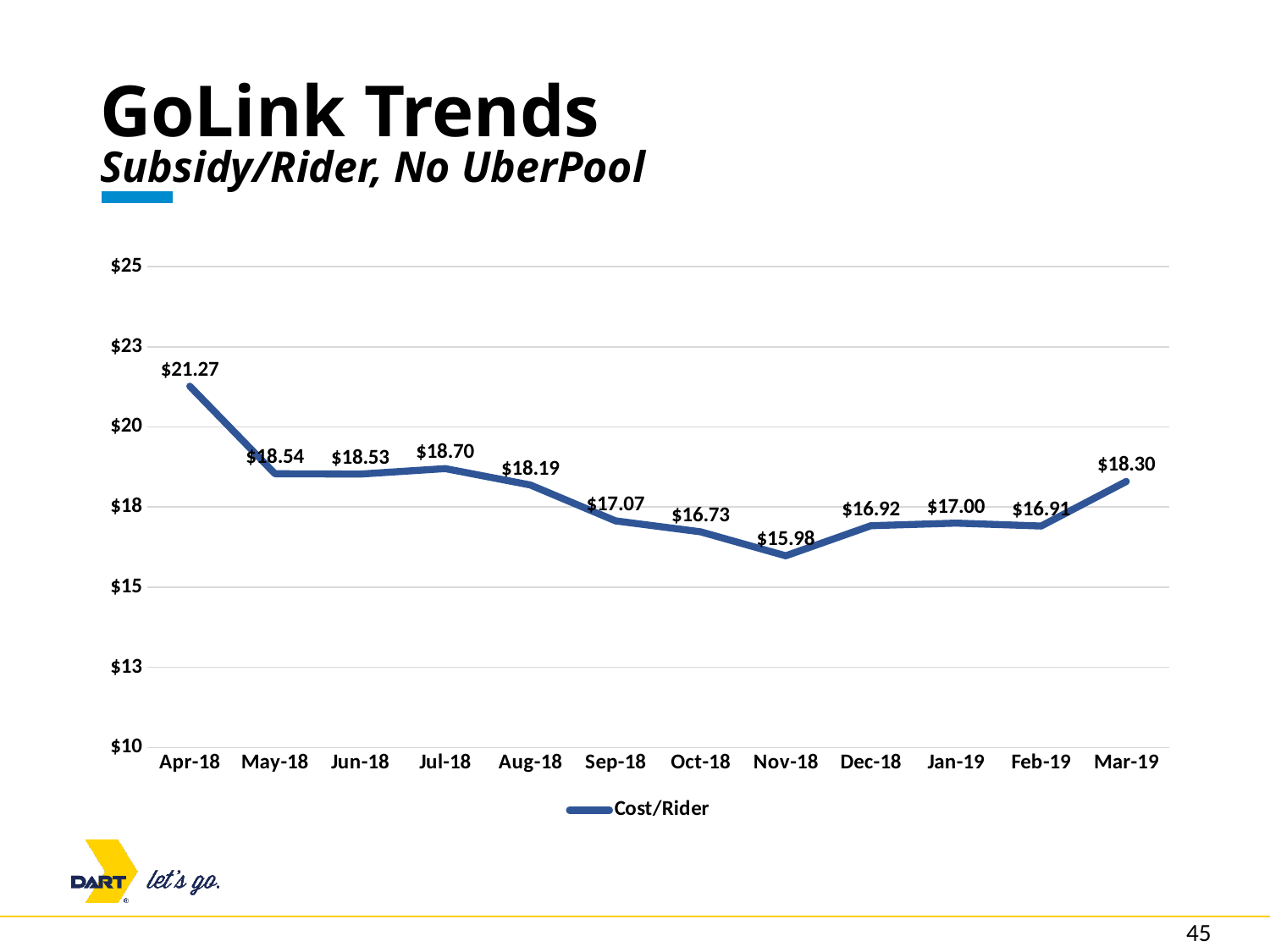
What is the Cost/Rider value for Nov-18? $15.98 What is the name of the series shown in the legend? Cost/Rider What kind of chart is shown on the slide? line chart Which has a higher Cost/Rider, Jul-18 or Sep-18? Jul-18 How many months are plotted on the chart? 12 What is the Cost/Rider value for Mar-19? $18.30 Which month has the highest Cost/Rider? Apr-18 Which month has the lowest Cost/Rider? Nov-18 Is the Cost/Rider for Oct-18 greater or less than $18? less What is the difference in Cost/Rider between Mar-19 and Feb-19? $1.39 What is the Cost/Rider value for Apr-18? $21.27 What is the difference in Cost/Rider between Apr-18 and May-18? $2.73